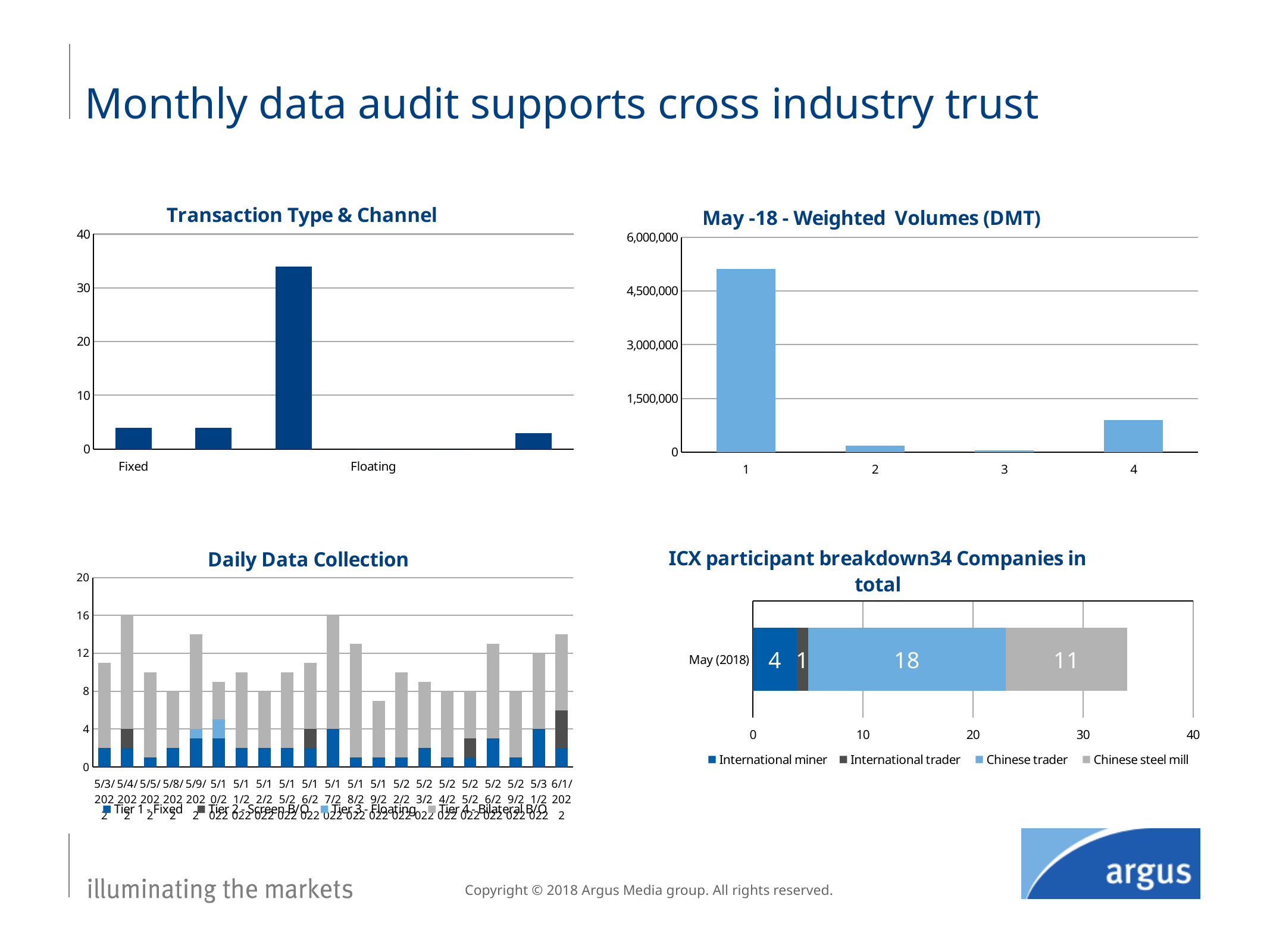
What kind of chart is 'May -18 - Weighted Volumes (DMT)'? Bar chart In the 'May -18 - Weighted Volumes (DMT)' chart, which category has the highest value? 1 In the 'ICX participant breakdown' chart, which is larger, Chinese steel mill or International miner? Chinese steel mill In the 'ICX participant breakdown' chart, what is the value for International miner? 4 How many series does the legend of the 'Daily Data Collection' chart list? 4 In the 'ICX participant breakdown' chart, what is the value for Chinese trader in May (2018)? 18 In the 'ICX participant breakdown' chart, which participant type has the smallest value? International trader In the 'Transaction Type & Channel' chart, is the value of the tallest bar greater or less than 30? greater In the 'May -18 - Weighted Volumes (DMT)' chart, is the value for category 4 greater or less than 1,500,000? less In the 'ICX participant breakdown' chart, what is the difference between Chinese trader and Chinese steel mill? 7 In the 'Transaction Type & Channel' chart, is the value for Fixed greater or less than 10? less In the 'ICX participant breakdown' chart, what is the total of the May (2018) stacked bar? 34